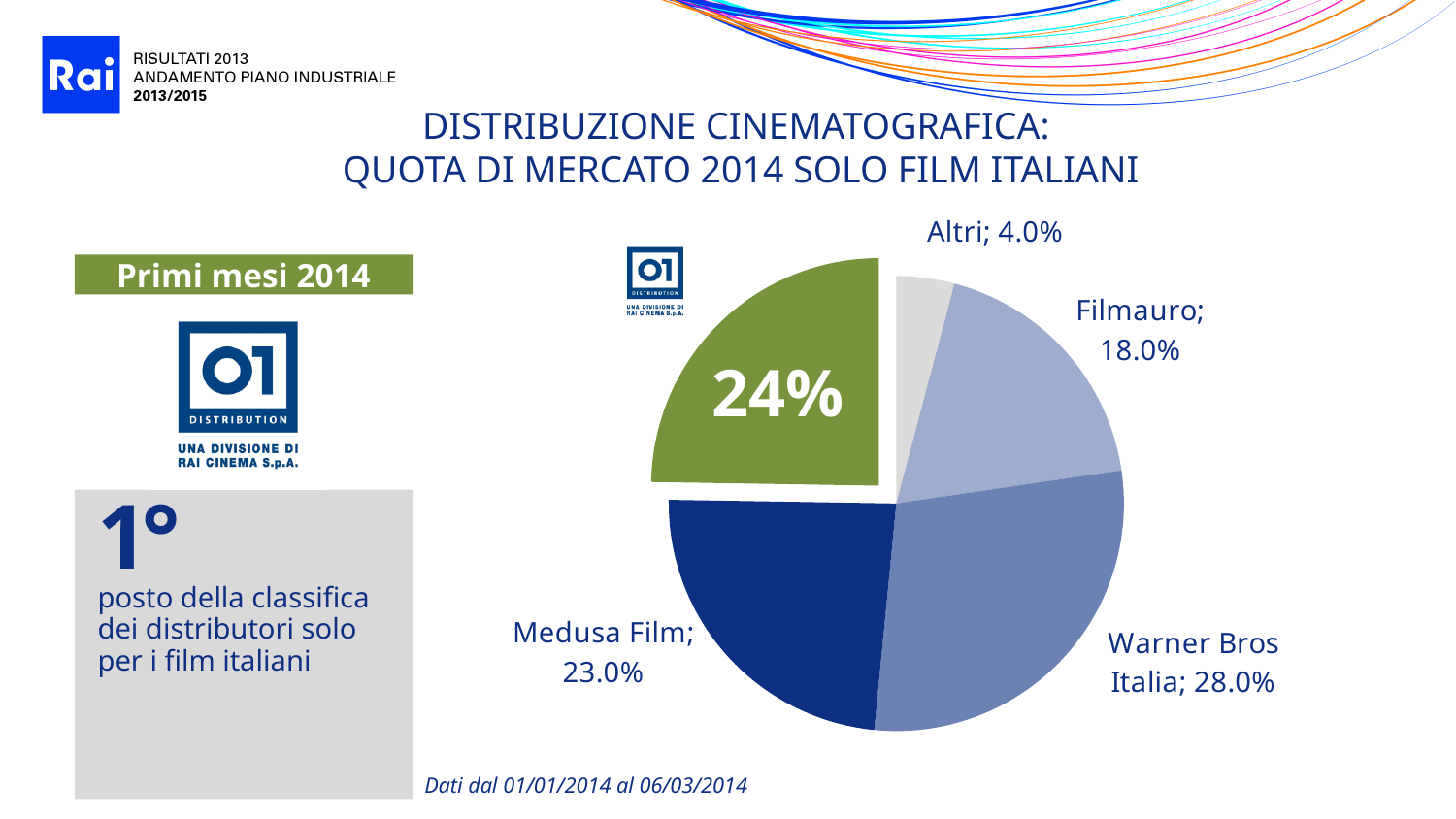
What is the market share shown for Altri? 4.0% What is the title of the chart on the slide? DISTRIBUZIONE CINEMATOGRAFICA: QUOTA DI MERCATO 2014 SOLO FILM ITALIANI What kind of chart is shown on the slide? pie chart Which distributor has the largest slice of the pie? Warner Bros Italia What is the difference between the Warner Bros Italia share and the Medusa Film share? 5.0% What share is printed on the green slice (01 Distribution)? 24% What is the market share shown for Warner Bros Italia? 28.0% How many slices does the pie chart have? 5 Which is larger, the share for Medusa Film or the share for Filmauro? Medusa Film What is the market share shown for Filmauro? 18.0% Which slice of the pie is the smallest? Altri What is the market share shown for Medusa Film? 23.0%